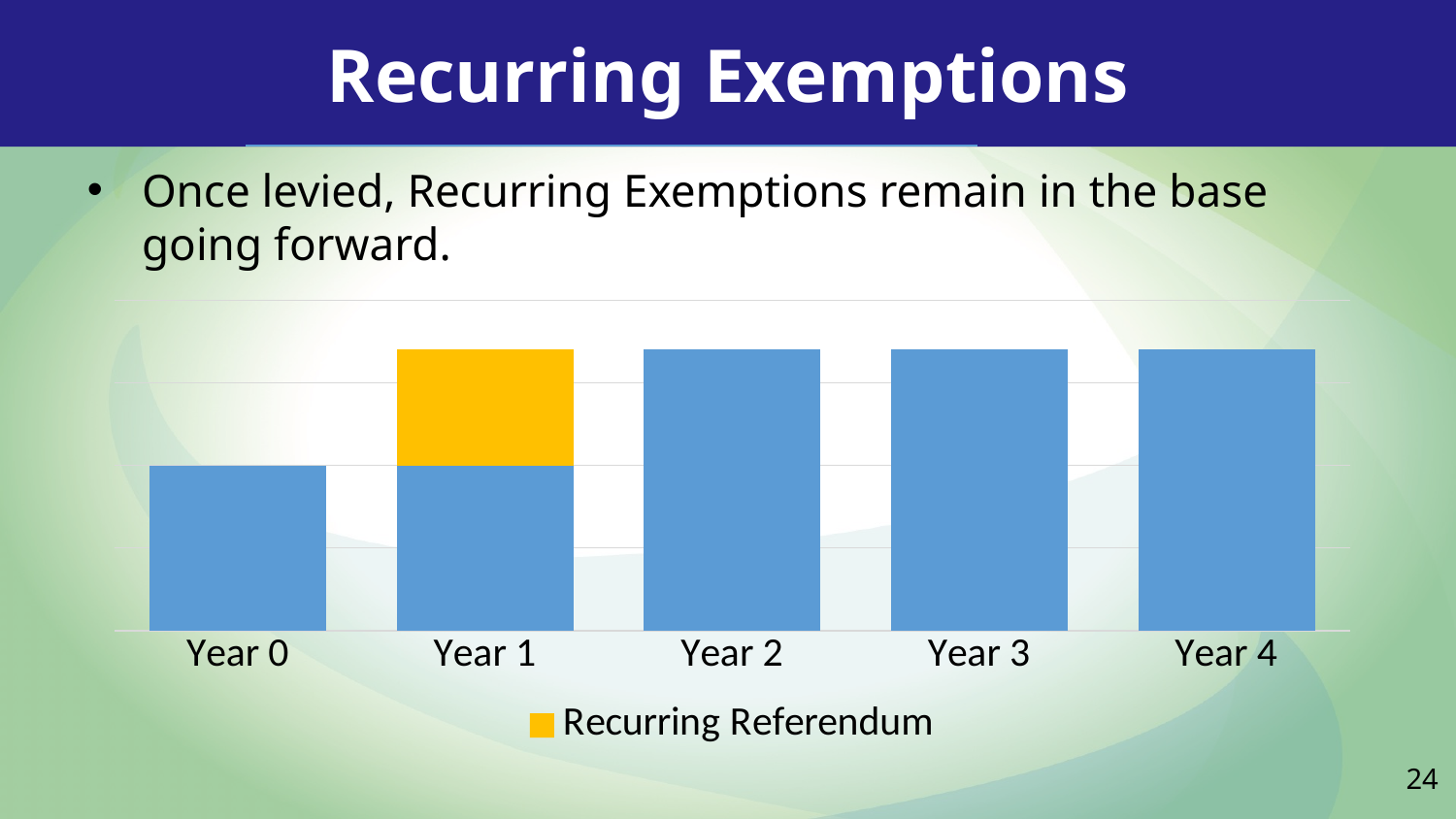
What colour represents Recurring Referendum in the chart? Yellow Which category is the only one with a Recurring Referendum segment? Year 1 How many categories are shown on the x axis of the chart? 5 Does the total bar height rise or fall from Year 0 to Year 1? Rise Which category has the lowest total bar height? Year 0 How many series does the chart's legend list? 1 What is the label of the last category on the x axis? Year 4 What is the label of the first category on the x axis? Year 0 What kind of chart is shown on the slide? Stacked bar chart Which bar is taller, Year 0 or Year 2? Year 2 What is the series name shown in the chart's legend? Recurring Referendum Which bar is taller, Year 0 or Year 4? Year 4